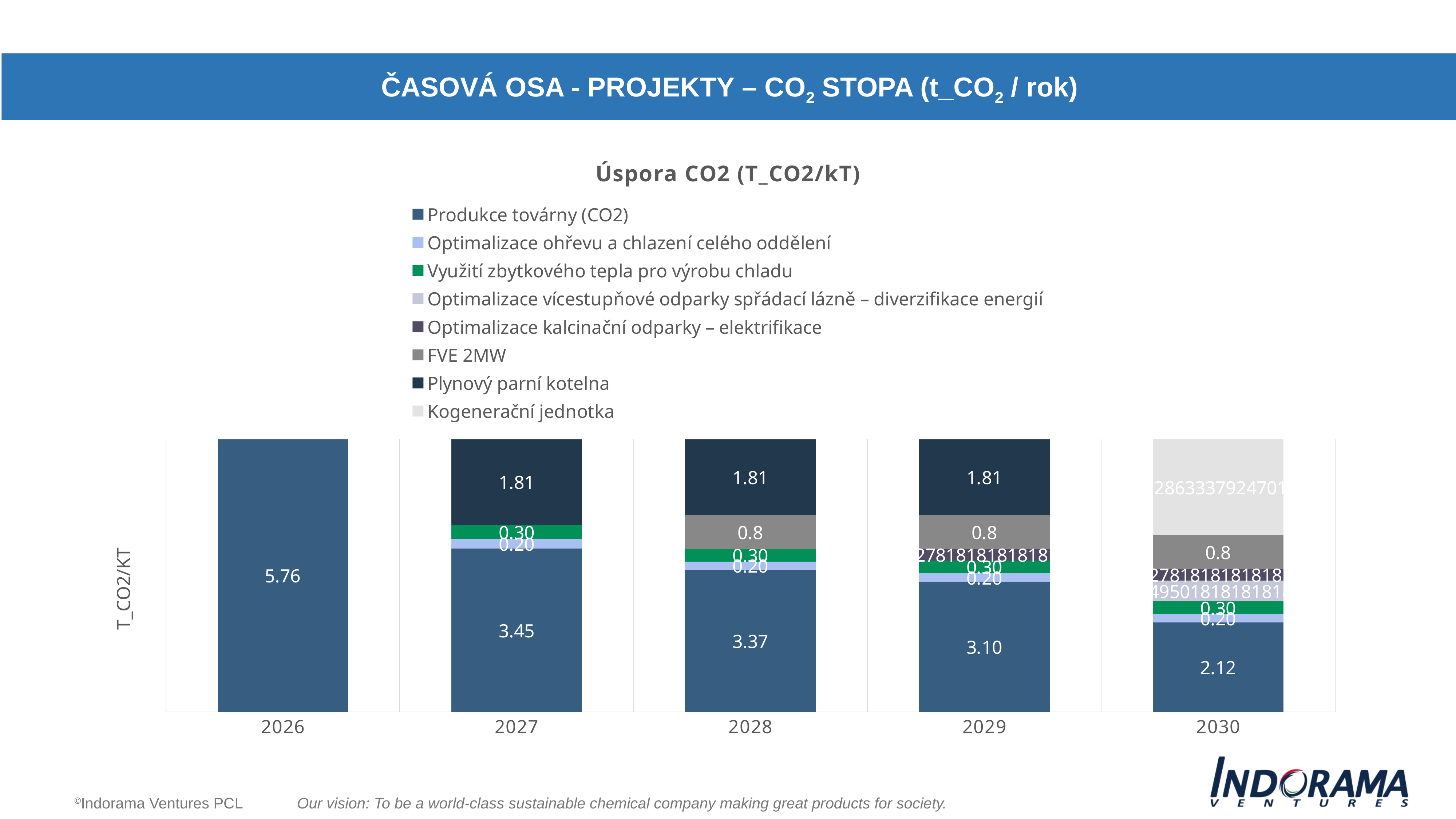
What is the difference between the Produkce továrny (CO2) values for 2026 and 2030? 3.64 What is the value of Optimalizace ohřevu a chlazení celého oddělení for 2028? 0.20 How many years are shown on the x axis? 5 What is the value of Plynový parní kotelna for 2027? 1.81 What is the value of Využití zbytkového tepla pro výrobu chladu for 2029? 0.30 Which is larger, the Produkce továrny (CO2) value for 2027 or for 2029? 2027 Does the value of Produkce továrny (CO2) rise or fall from 2026 to 2030? Fall What is the value of Produkce továrny (CO2) for 2026? 5.76 What is the value of FVE 2MW for 2028? 0.8 How many series does the legend list? 8 What kind of chart is shown? Stacked bar chart What is the value of Produkce továrny (CO2) for 2030? 2.12